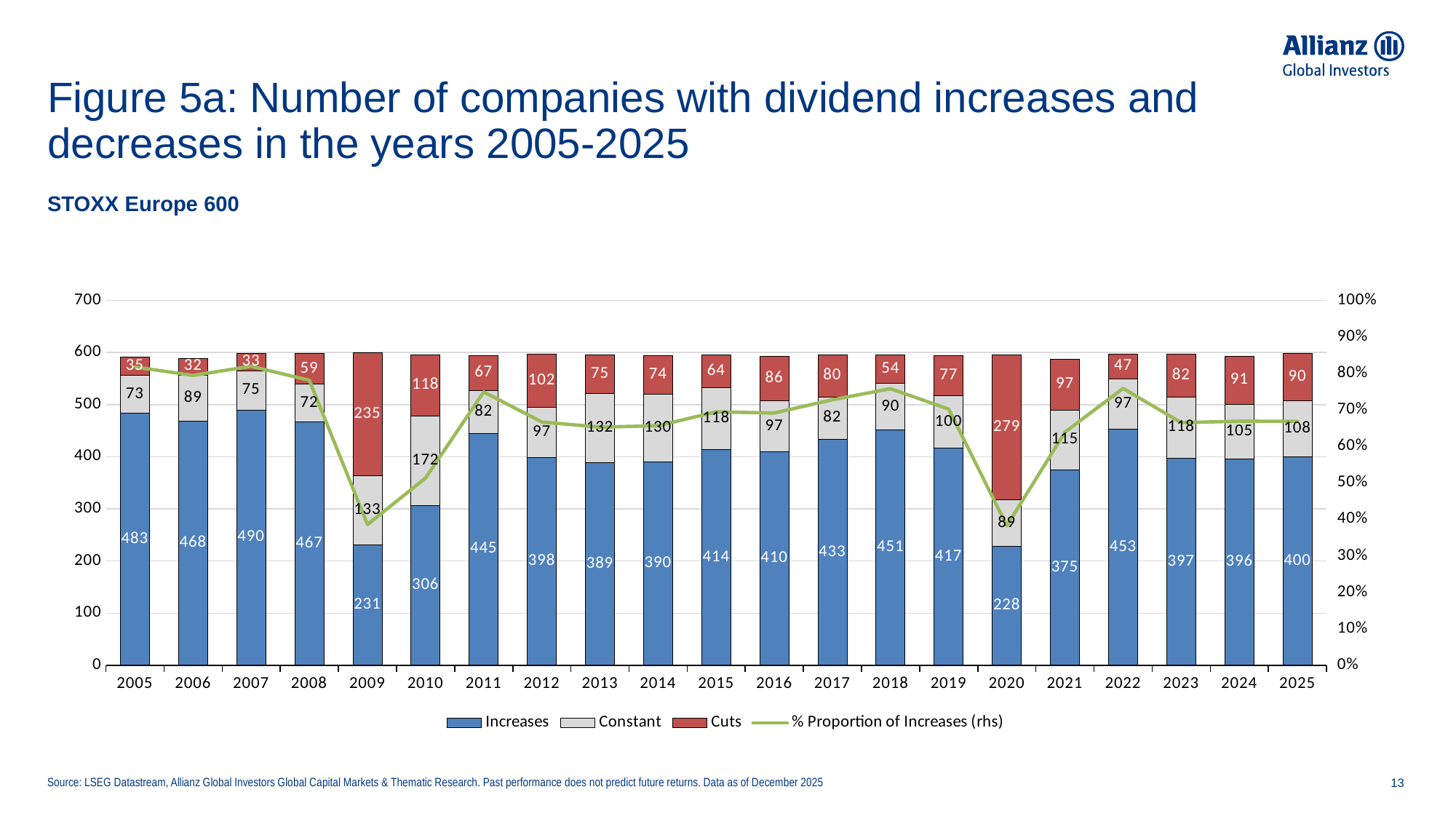
What is the difference between the Increases values for 2022 and 2021? 78 What is the value for Constant in 2010? 172 What is the value for Cuts in 2020? 279 How many companies had dividend increases in 2007? 490 Is the % Proportion of Increases for 2009 greater or less than 50%? less How many series does the legend list? 4 What kind of chart is shown on the slide? Stacked bar chart with a line Which is larger, the Cuts value in 2009 or the Cuts value in 2010? 2009 What is the total of the stacked bar for 2025? 598 In which year is the Increases value the lowest? 2020 How many years are shown on the x axis? 21 In which year is the Cuts value the highest? 2020